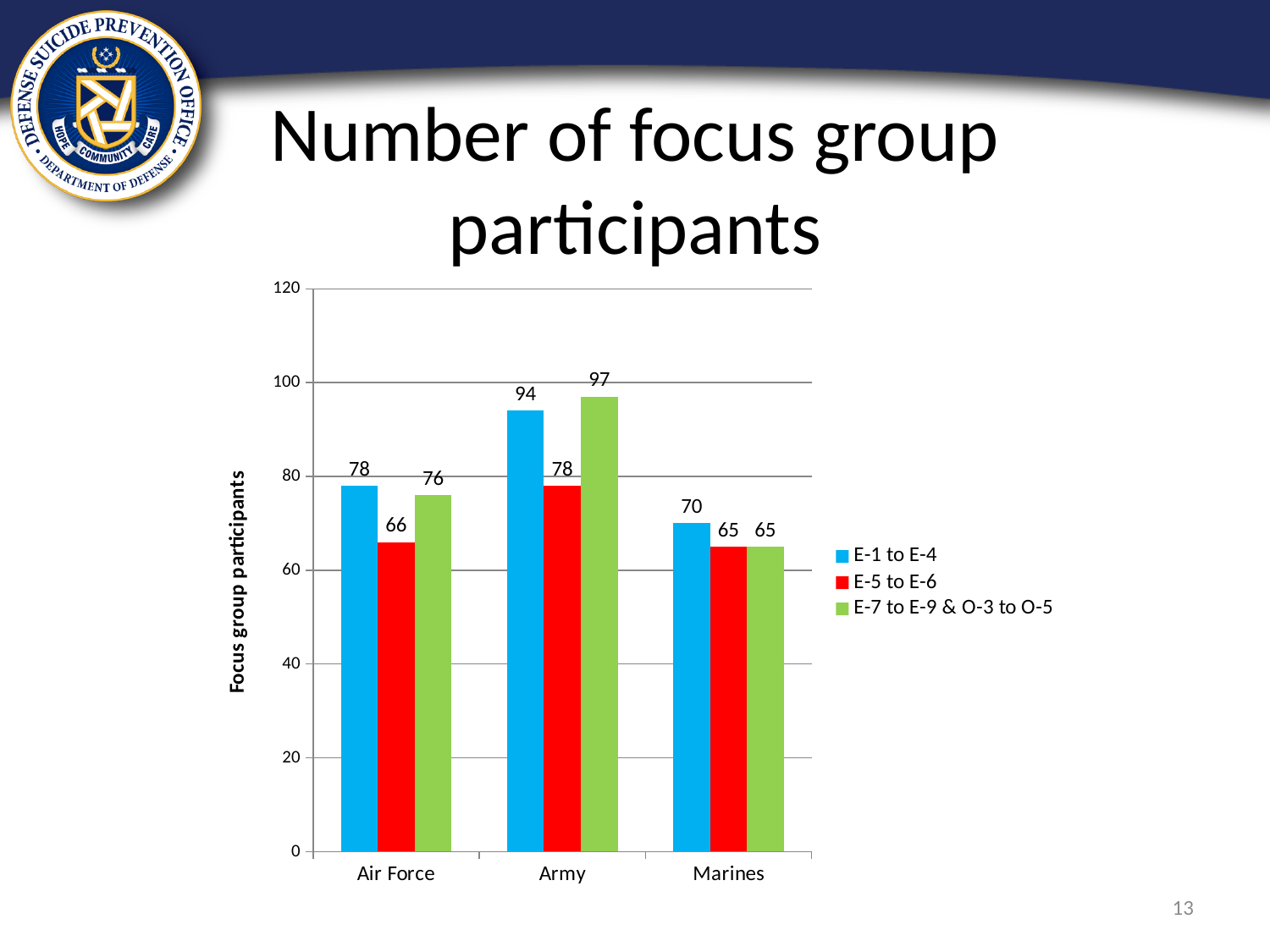
Which service has the lowest number of E-1 to E-4 focus group participants? Marines How many series does the legend list? 3 What is the value for E-7 to E-9 & O-3 to O-5 for the Marines? 65 How many focus group participants from E-1 to E-4 were there for the Army? 94 What is the value for E-5 to E-6 in the Air Force? 66 What kind of chart is shown on the slide? Bar chart What is the difference between the E-7 to E-9 & O-3 to O-5 value and the E-5 to E-6 value for the Army? 19 Is the E-5 to E-6 value for the Marines greater or less than 80? less How many services are shown on the x axis? 3 What is the label of the y axis? Focus group participants Which is larger: the E-1 to E-4 value for the Air Force or the E-1 to E-4 value for the Marines? Air Force Which service has the highest number of E-7 to E-9 & O-3 to O-5 focus group participants? Army